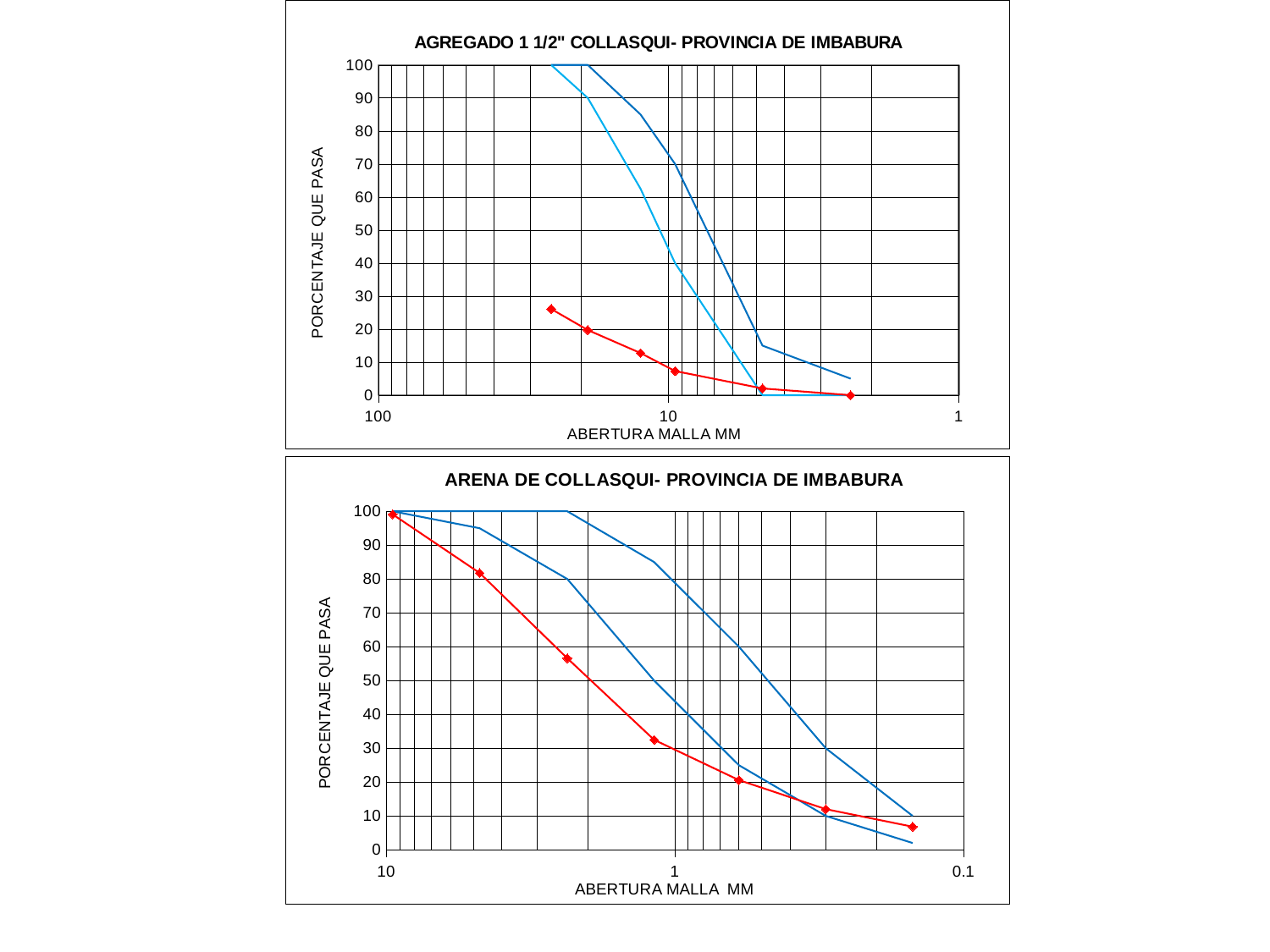
In the bottom chart, is the value of the rightmost red data point greater or less than 10? less What kind of chart is the bottom chart titled "ARENA DE COLLASQUI- PROVINCIA DE IMBABURA"? line chart In the top chart, how many lines are plotted? 3 In the top chart, how many marked data points does the red line have? 6 In the bottom chart, how many marked data points does the red line have? 7 In the bottom chart, does the red line rise or fall from left to right along the x axis? fall In the bottom chart, how many lines are plotted? 3 In the top chart, is the value of the leftmost red data point greater or less than 20? greater In the top chart, what is the label of the vertical axis? PORCENTAJE QUE PASA In the top chart, does the red line rise or fall from left to right along the x axis? fall What kind of chart is the top chart titled "AGREGADO 1 1/2" COLLASQUI- PROVINCIA DE IMBABURA"? line chart What is the title of the bottom chart? ARENA DE COLLASQUI- PROVINCIA DE IMBABURA